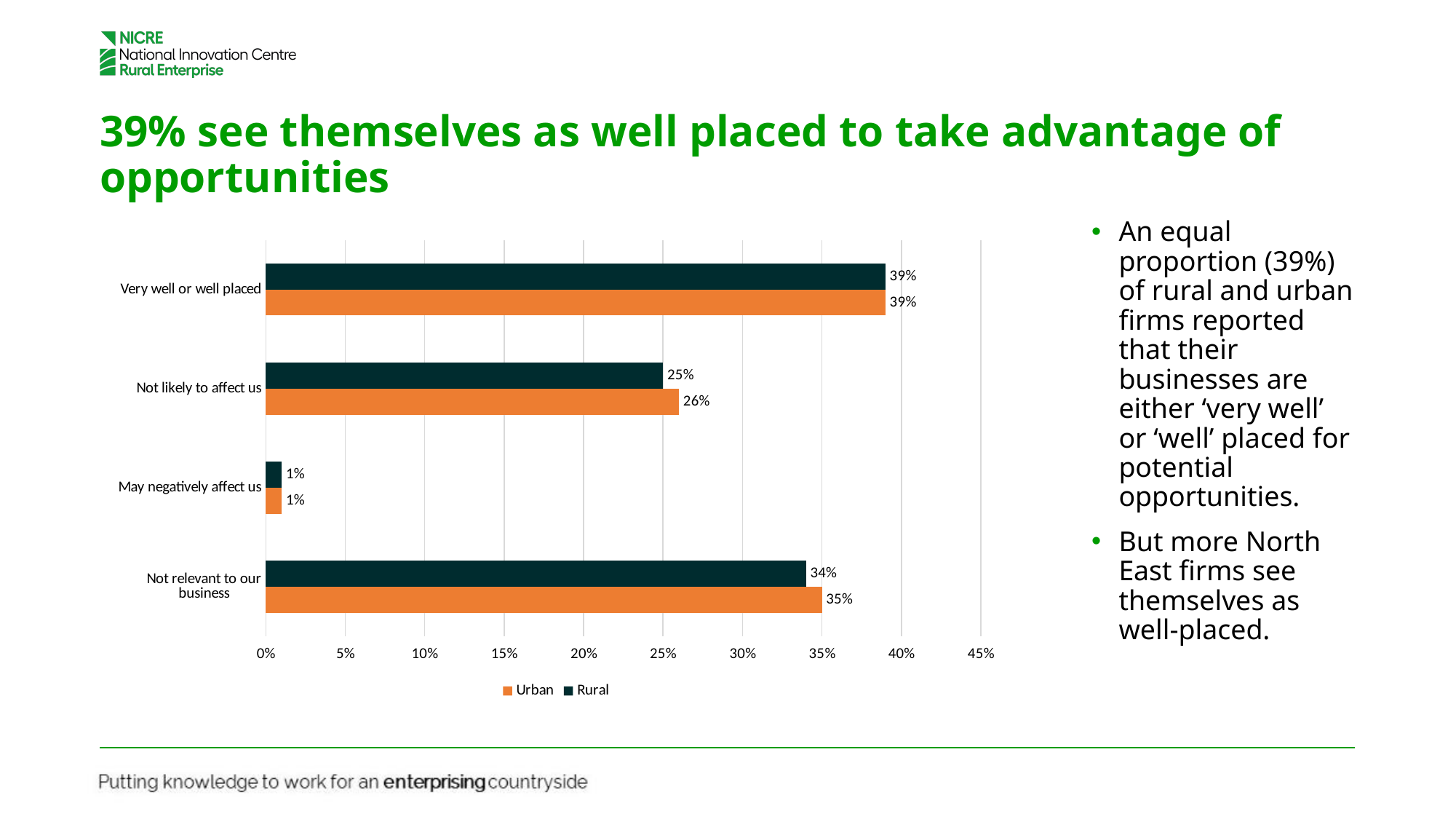
What is the Urban value for 'May negatively affect us'? 1% How many series does the legend list? 2 What is the difference between the Urban and Rural values for 'Not relevant to our business'? 1% How many categories are shown on the chart? 4 Which category has the highest Urban value? Very well or well placed What kind of chart is shown on the slide? Bar chart For 'Not likely to affect us', which is larger, the Urban or the Rural value? Urban What is the Rural value for 'Very well or well placed'? 39% What is the Rural value for 'Not relevant to our business'? 34% Which category has the lowest Rural value? May negatively affect us Which colour represents the Rural series in the chart? Dark green What is the Urban value for 'Not likely to affect us'? 26%